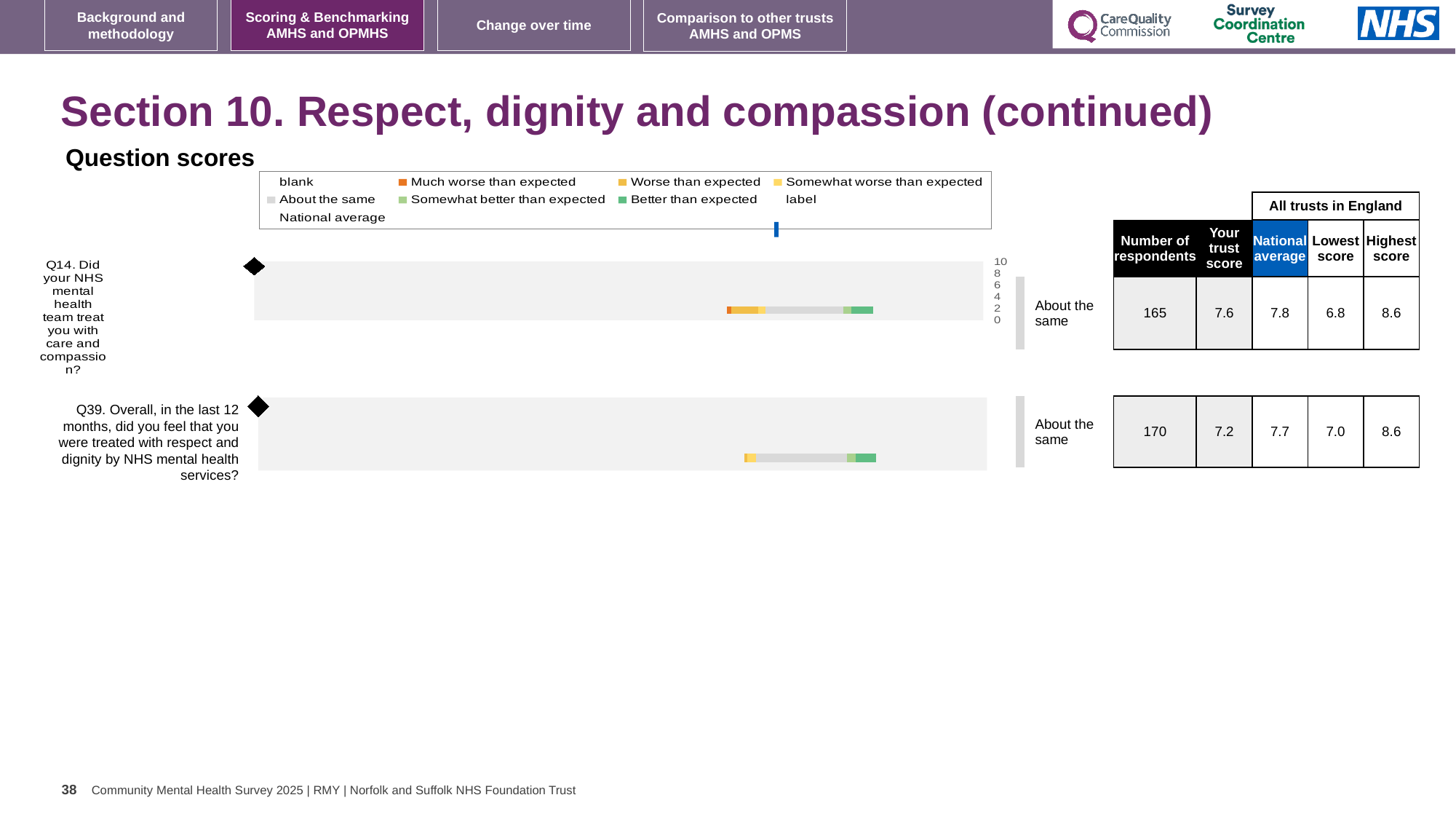
What is the lowest score among all trusts in England for Q14? 6.8 What is the trust score for Q14 (care and compassion)? 7.6 What kind of chart is used to show the question scores on this slide? bar chart Which question has the higher trust score, Q14 or Q39? Q14 How is the trust's result for Q14 categorised relative to other trusts? About the same What is the difference between the highest and lowest scores for Q14? 1.8 What is the national average for Q39 (treated with respect and dignity)? 7.7 What is the difference between the national average and the trust score for Q39? 0.5 What is the highest score among all trusts in England for Q39? 8.6 How many questions are plotted in the question scores chart? 2 Which question has more respondents, Q14 or Q39? Q39 How many respondents answered Q39? 170